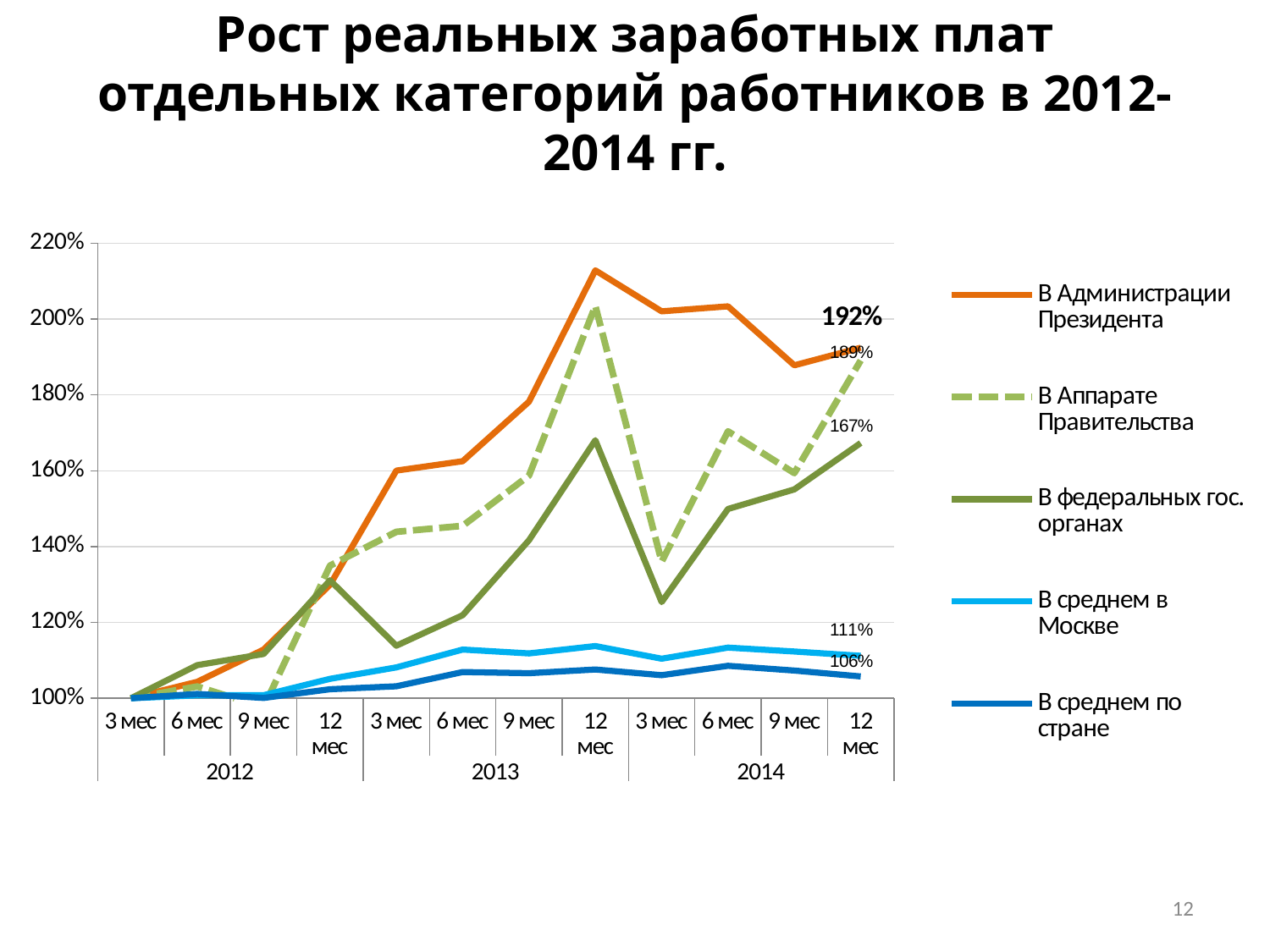
What is the value for 'В федеральных гос. органах' at 12 мес 2014? 167% What is the value for 'В среднем в Москве' at 12 мес 2014? 111% Which series has the highest value at 12 мес 2014? В Администрации Президента How many time points are plotted along the x axis? 12 What is the difference between 'В среднем в Москве' and 'В среднем по стране' at 12 мес 2014? 5 percentage points Is the value for 'В Администрации Президента' at 12 мес 2013 greater or less than 200%? greater Is the value for 'В федеральных гос. органах' at 3 мес 2014 greater or less than 140%? less What kind of chart is shown on the slide? line chart How many series does the legend list? 5 Which series is drawn with a dashed line? В Аппарате Правительства Which series has the lowest value at 12 мес 2014? В среднем по стране What is the value for 'В среднем по стране' at 12 мес 2014? 106%